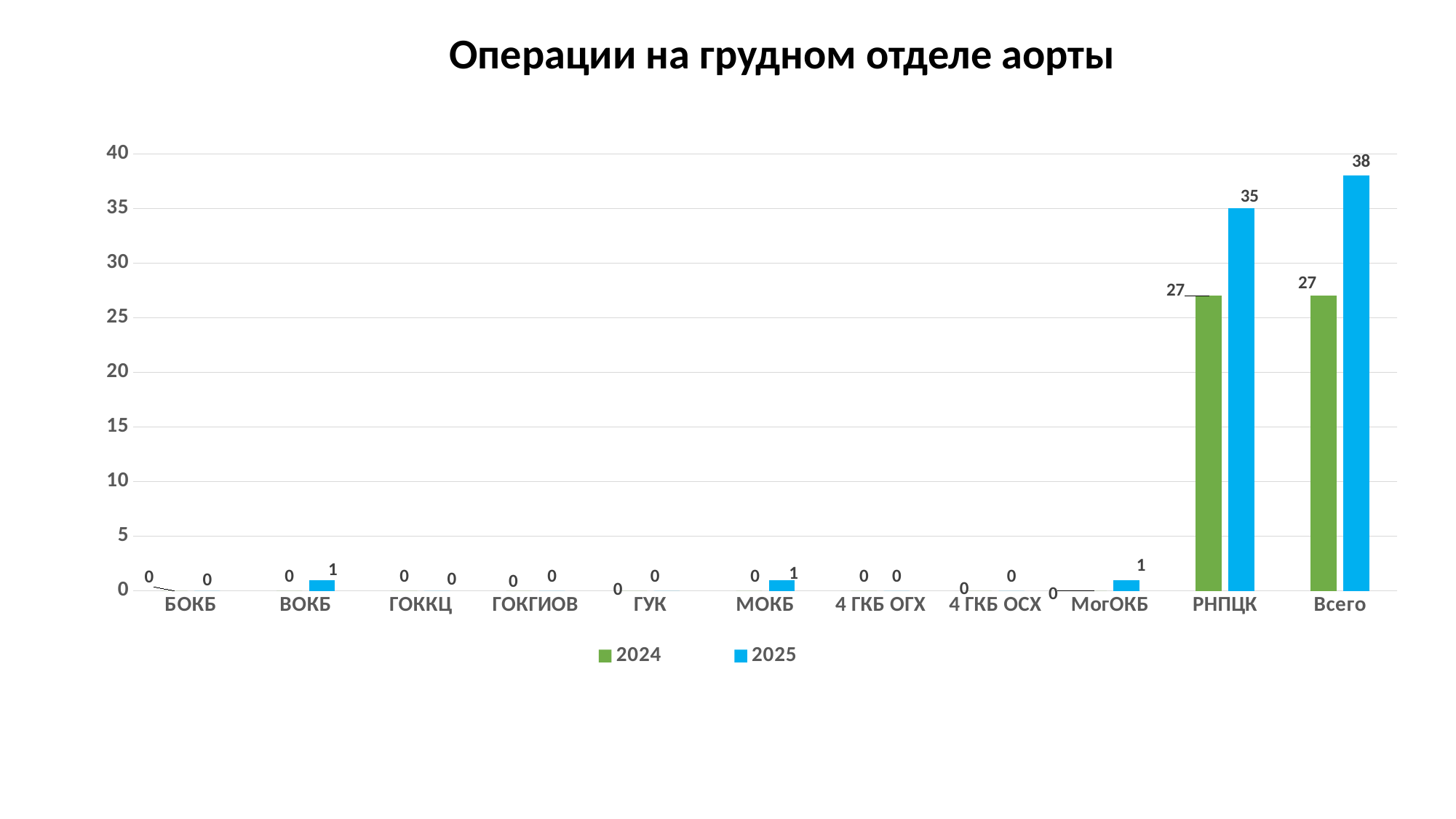
What is the 2024 value for МОКБ? 0 What is the 2024 value for Всего? 27 How many series does the legend list? 2 What is the difference between the 2025 and 2024 values for РНПЦК? 8 Which is larger for РНПЦК, the 2024 value or the 2025 value? 2025 What is the 2025 value for ВОКБ? 1 What is the title of the chart? Операции на грудном отделе аорты Which category has the highest 2025 value? Всего What is the 2025 value for РНПЦК? 35 What is the difference between the 2025 and 2024 values for Всего? 11 What kind of chart is shown? bar chart How many categories are shown on the x axis? 11